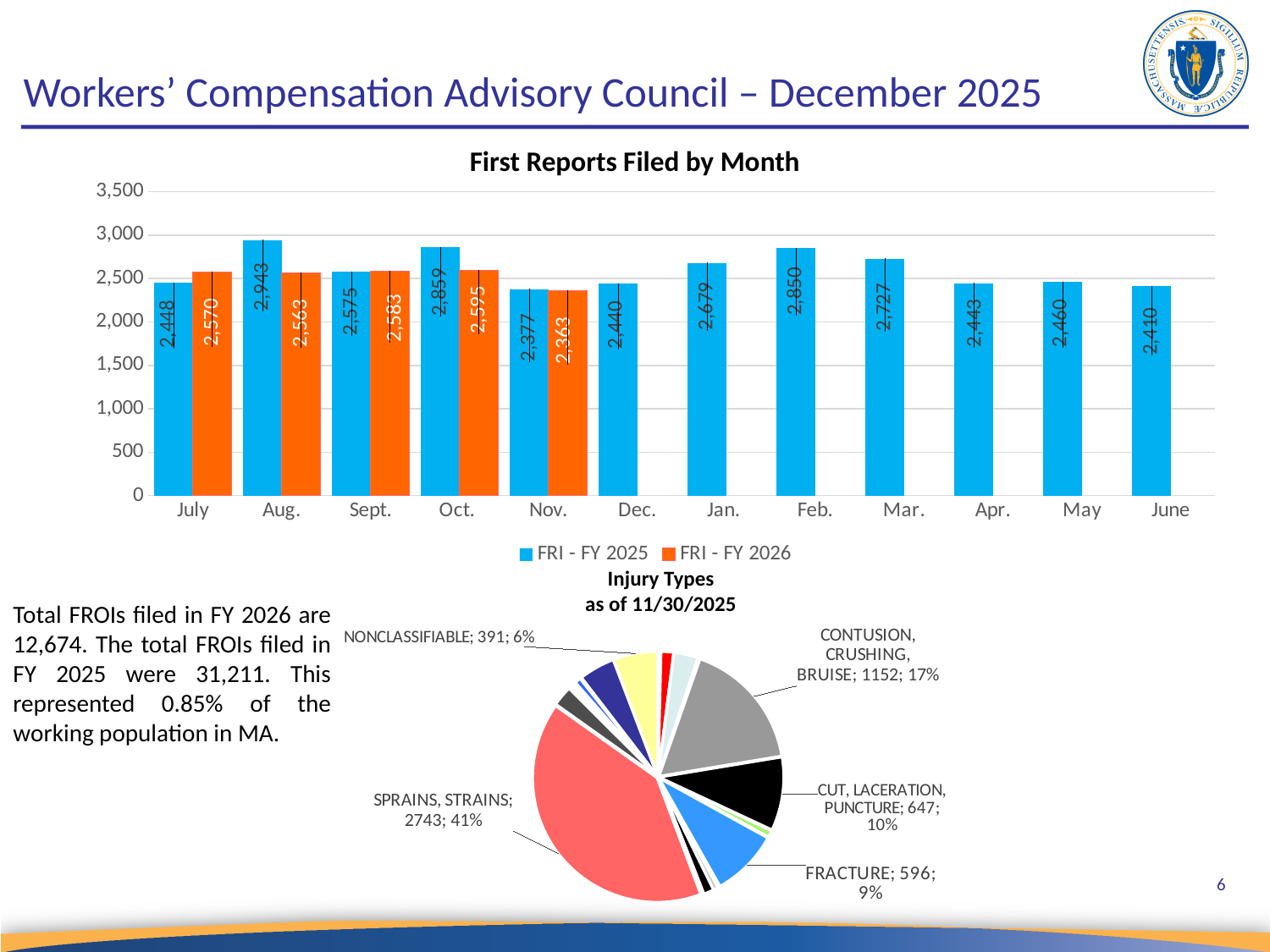
In the 'First Reports Filed by Month' chart, what is the FRI - FY 2025 value for August? 2,943 In the 'First Reports Filed by Month' chart, what is the FRI - FY 2026 value for October? 2,595 In the 'Injury Types as of 11/30/2025' pie chart, what is the difference between the CONTUSION, CRUSHING, BRUISE value and the CUT, LACERATION, PUNCTURE value? 505 In the 'Injury Types as of 11/30/2025' pie chart, what is the value for FRACTURE? 596 In the 'First Reports Filed by Month' chart, which is larger for September: FRI - FY 2025 or FRI - FY 2026? FRI - FY 2026 In the 'Injury Types as of 11/30/2025' pie chart, what share does SPRAINS, STRAINS represent? 41% In the 'First Reports Filed by Month' chart, what is the difference between the FRI - FY 2026 and FRI - FY 2025 values for July? 122 In the 'First Reports Filed by Month' chart, which month has the lowest FRI - FY 2026 value? Nov. In the 'First Reports Filed by Month' chart, how many series does the legend list? 2 What kind of chart is 'First Reports Filed by Month'? Bar chart In the 'First Reports Filed by Month' chart, how many months are shown on the x axis? 12 In the 'First Reports Filed by Month' chart, which month has the highest FRI - FY 2025 value? Aug.